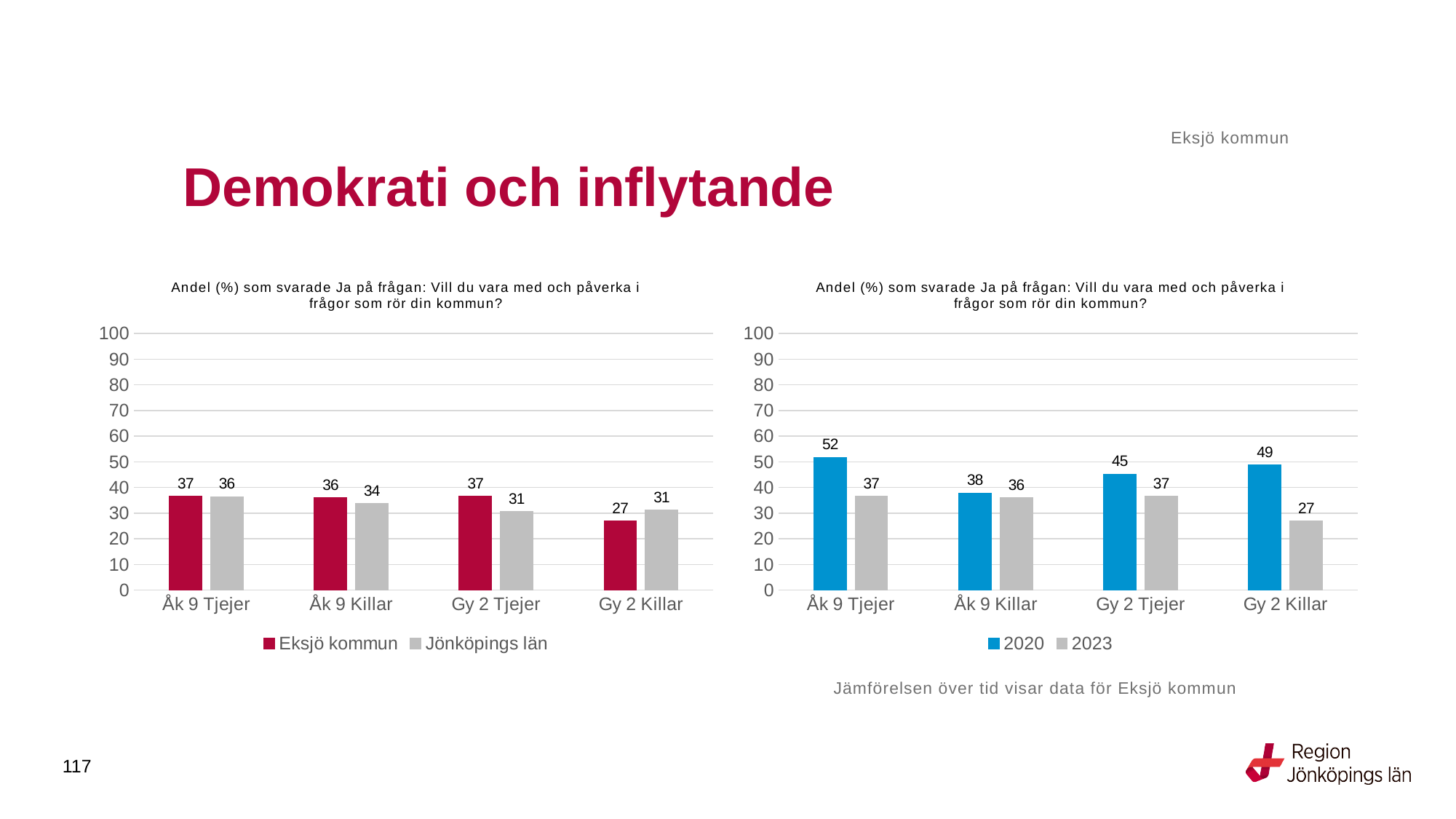
In the left chart, what is the difference between Eksjö kommun and Jönköpings län for Gy 2 Tjejer? 6 In the left chart, what is the value for Jönköpings län for Åk 9 Killar? 34 In the left chart, which is larger for Gy 2 Killar: Eksjö kommun or Jönköpings län? Jönköpings län In the left chart, what is the value for Eksjö kommun for Gy 2 Killar? 27 What type of chart is the left chart? Bar chart In the right chart, which category has the highest value for 2020? Åk 9 Tjejer In the right chart, is the 2020 value for Åk 9 Tjejer greater or less than 50? greater How many series does the legend of the right chart list? 2 How many categories are shown on the x axis of the left chart? 4 In the right chart, what is the value for 2020 for Gy 2 Tjejer? 45 In the right chart, what is the difference between the 2020 and 2023 values for Gy 2 Killar? 22 In the right chart, which category has the lowest value for 2023? Gy 2 Killar